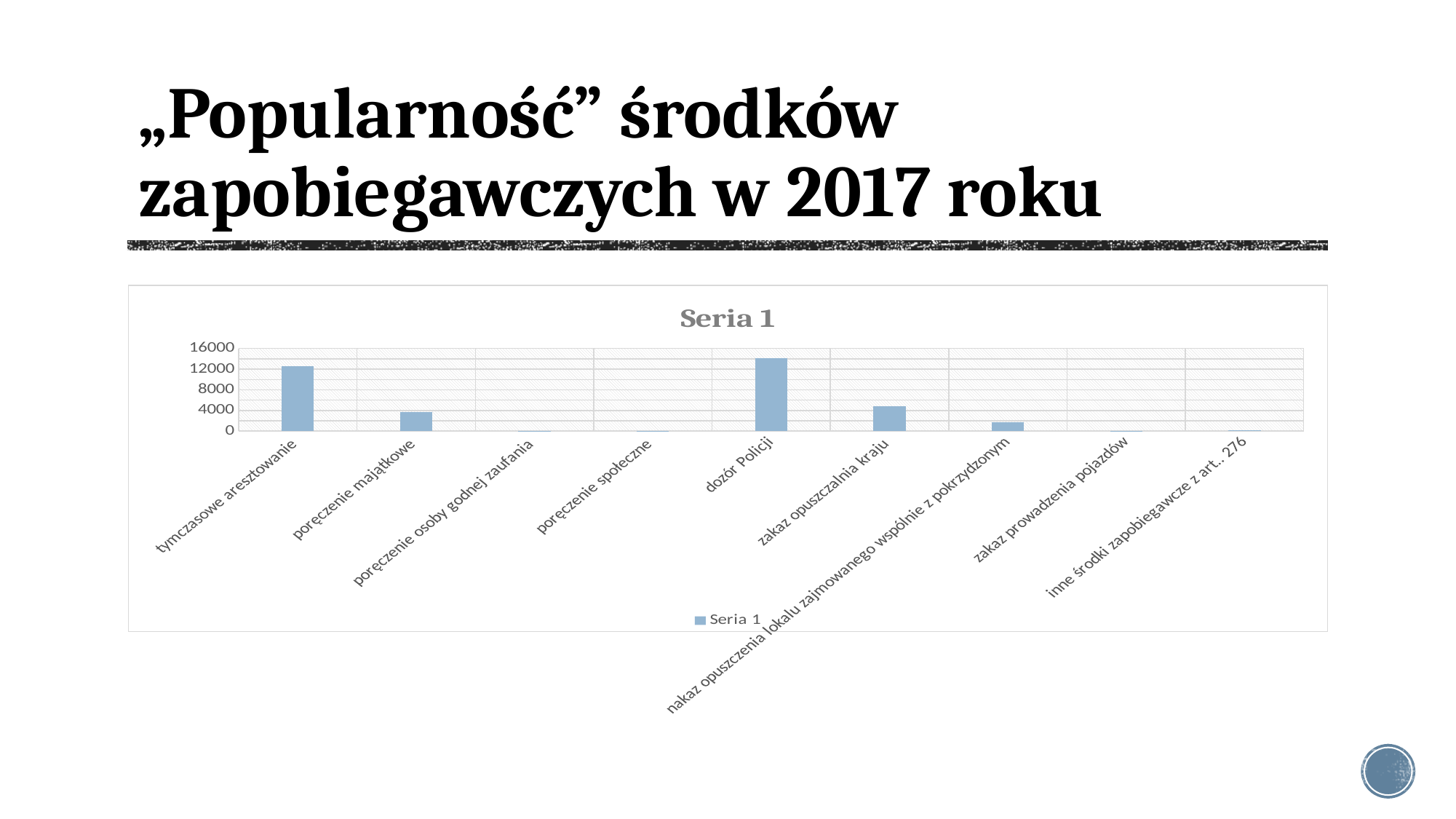
Which is larger, the value for zakaz opuszczalnia kraju or the value for nakaz opuszczenia lokalu zajmowanego wspólnie z pokrzydzonym? zakaz opuszczalnia kraju Which category has the highest value in the chart? dozór Policji What kind of chart is shown on the slide? bar chart Is the value for poręczenie majątkowe greater or less than 4000? less Is the value for nakaz opuszczenia lokalu zajmowanego wspólnie z pokrzydzonym greater or less than 4000? less Which is larger, the value for tymczasowe aresztowanie or the value for poręczenie majątkowe? tymczasowe aresztowanie How many series does the chart's legend list? 1 Is the value for tymczasowe aresztowanie greater or less than 8000? greater How many categories are plotted on the x axis of the chart? 9 What is the title of the chart? Seria 1 What is the highest value shown on the chart's vertical axis? 16000